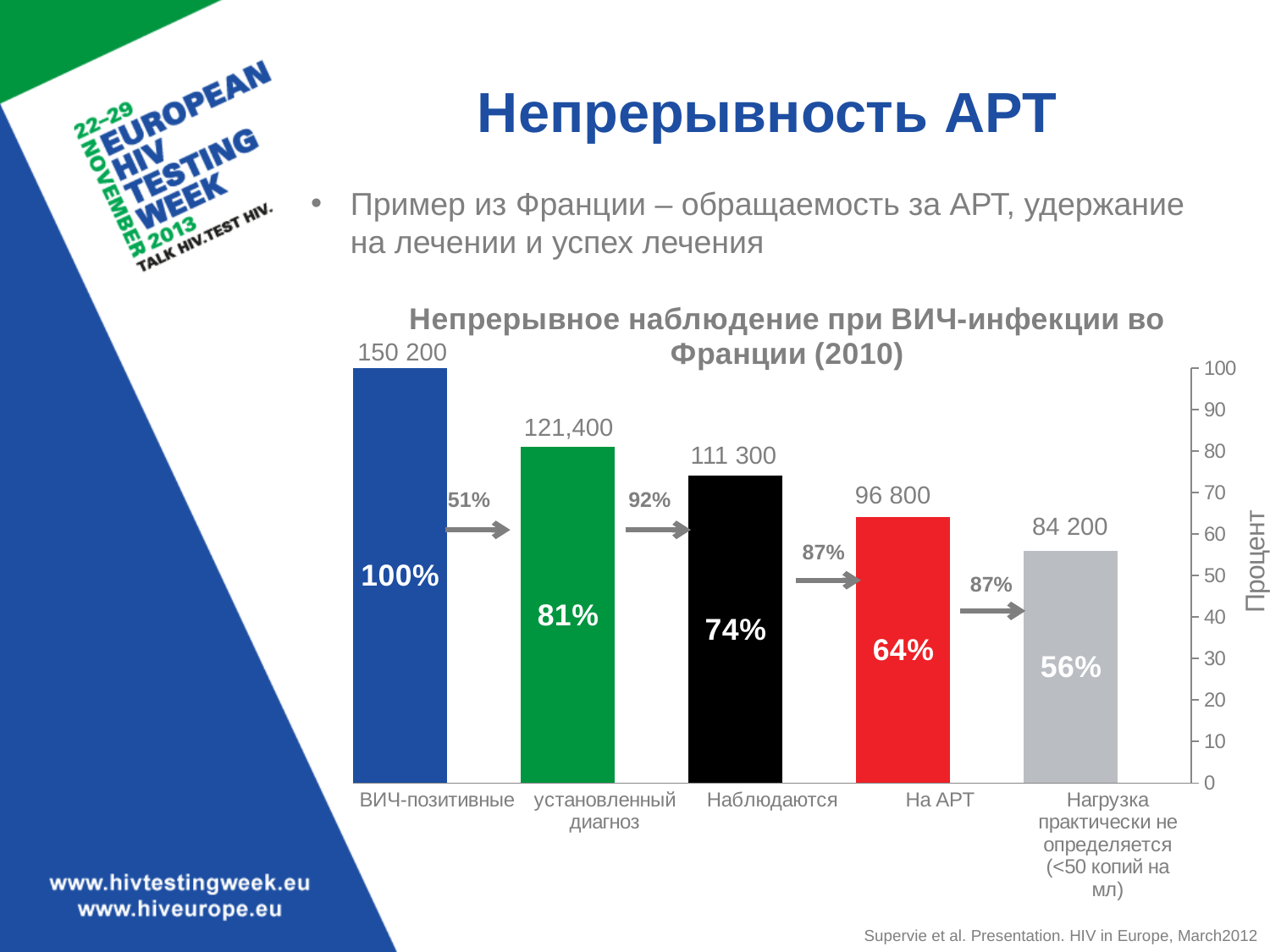
Which category has the lowest bar? Нагрузка практически не определяется (<50 копий на мл) What percentage is printed inside the bar for установленный диагноз? 81% Which category has the highest bar? ВИЧ-позитивные How many categories (bars) does the chart show? 5 What type of chart is shown on the slide? bar chart What is the chart title? Непрерывное наблюдение при ВИЧ-инфекции во Франции (2010) What number is printed above the bar for Наблюдаются? 111 300 What percentage is printed inside the bar for На АРТ? 64% What is the difference in percentage points between the bars for Наблюдаются (74%) and На АРТ (64%)? 10 What number is printed above the bar for ВИЧ-позитивные? 150 200 Do the bar values rise or fall from left to right across the categories? fall What number is printed above the bar for Нагрузка практически не определяется (<50 копий на мл)? 84 200